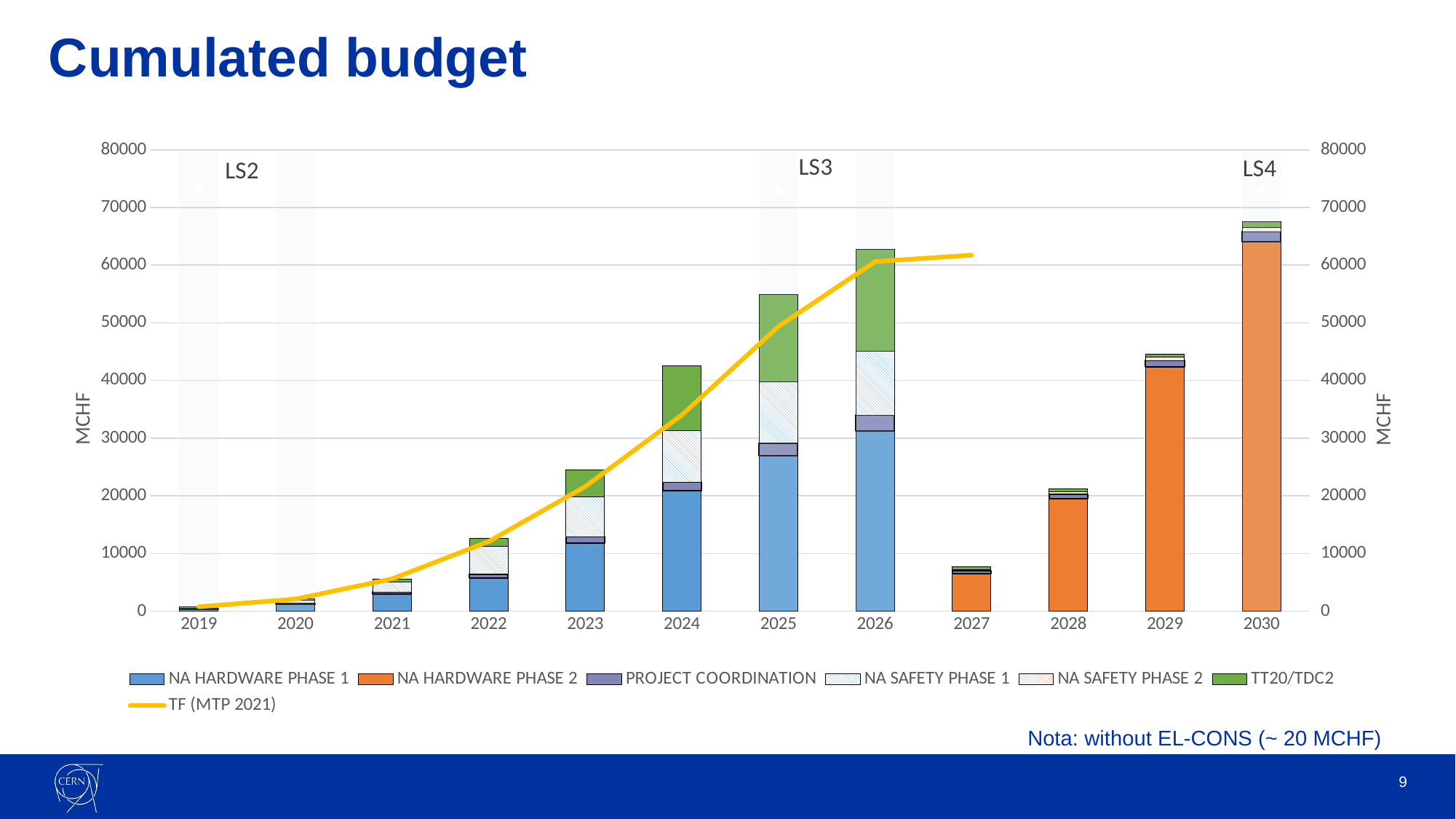
What kind of chart is shown on the slide? Stacked bar chart with a line Which stacked bar is taller, 2026 or 2025? 2026 Which year has the tallest stacked bar? 2030 How many years are shown on the x axis of the chart? 12 How many series does the chart legend list? 7 Do the stacked bar totals rise or fall from 2019 to 2026? rise Is the total of the stacked bar for 2026 greater or less than 60000? greater What is the label on the vertical axis of the chart? MCHF Is the total of the stacked bar for 2027 greater or less than 10000? less Is the total of the stacked bar for 2024 greater or less than 40000? greater Which year has the shortest stacked bar? 2019 Which stacked bar is taller, 2029 or 2028? 2029